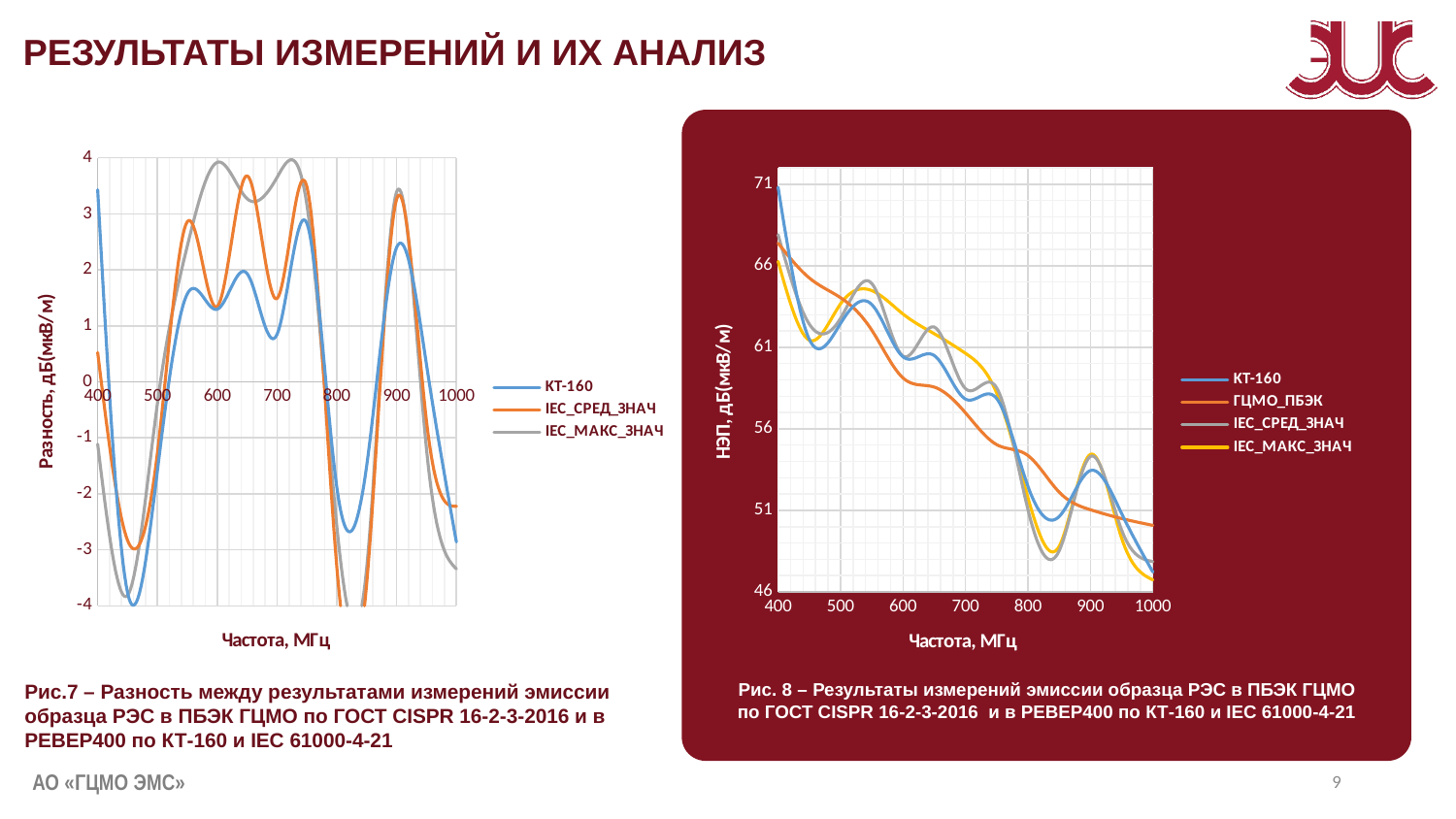
How many series does the legend of the right chart (Рис. 8) list? 4 What is the y-axis label of the right chart (Рис. 8)? НЭП, дБ(мкВ/м) What is the x-axis label of the left chart (Рис.7)? Частота, МГц What kind of chart is Рис. 8 on the right of the slide? line chart In the right chart (Рис. 8), is the value of KT-160 at 1000 МГц greater or less than 51? less In the left chart (Рис.7), is the value of IEC_МАКС_ЗНАЧ at 600 МГц greater or less than 3? greater What kind of chart is Рис.7 on the left of the slide? line chart In the right chart (Рис. 8), is the value of ГЦМО_ПБЭК at 600 МГц greater or less than 56? greater In the right chart (Рис. 8), do the values generally rise or fall as frequency increases from 400 to 1000 МГц? fall How many series does the legend of the left chart (Рис.7) list? 3